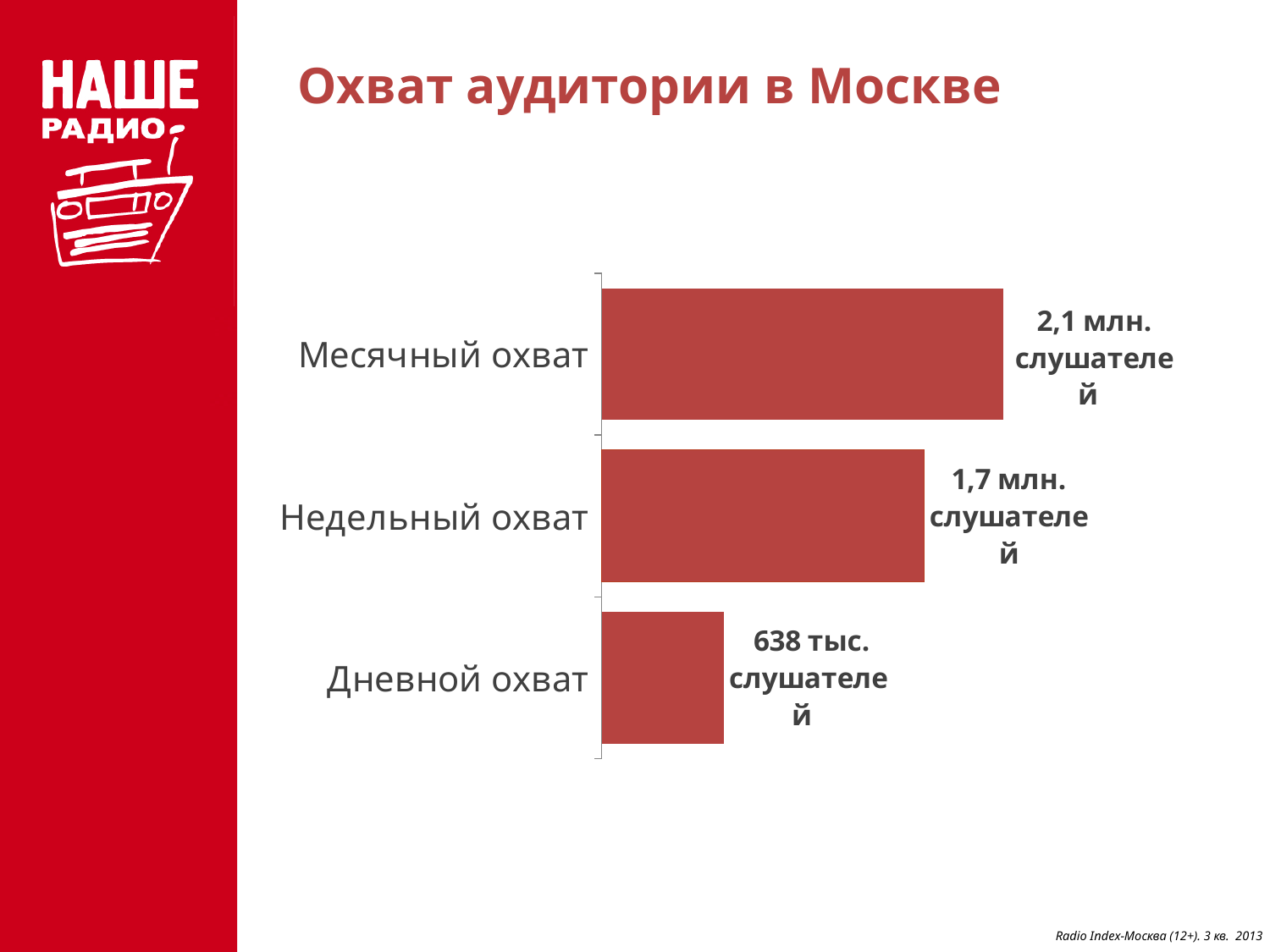
What is the value shown for Недельный охват? 1,7 млн. слушателей What is the title of the slide? Охват аудитории в Москве Which is larger, Недельный охват or Дневной охват? Недельный охват What kind of chart is shown on the slide? Bar chart Which category has the highest value? Месячный охват What colour are the bars in the chart? Red What is the difference between Месячный охват and Недельный охват? 0,4 млн. слушателей What is the value shown for Дневной охват? 638 тыс. слушателей What is the value shown for Месячный охват? 2,1 млн. слушателей How many categories are shown in the chart? 3 Which is larger, Месячный охват or Недельный охват? Месячный охват Which category has the lowest value? Дневной охват